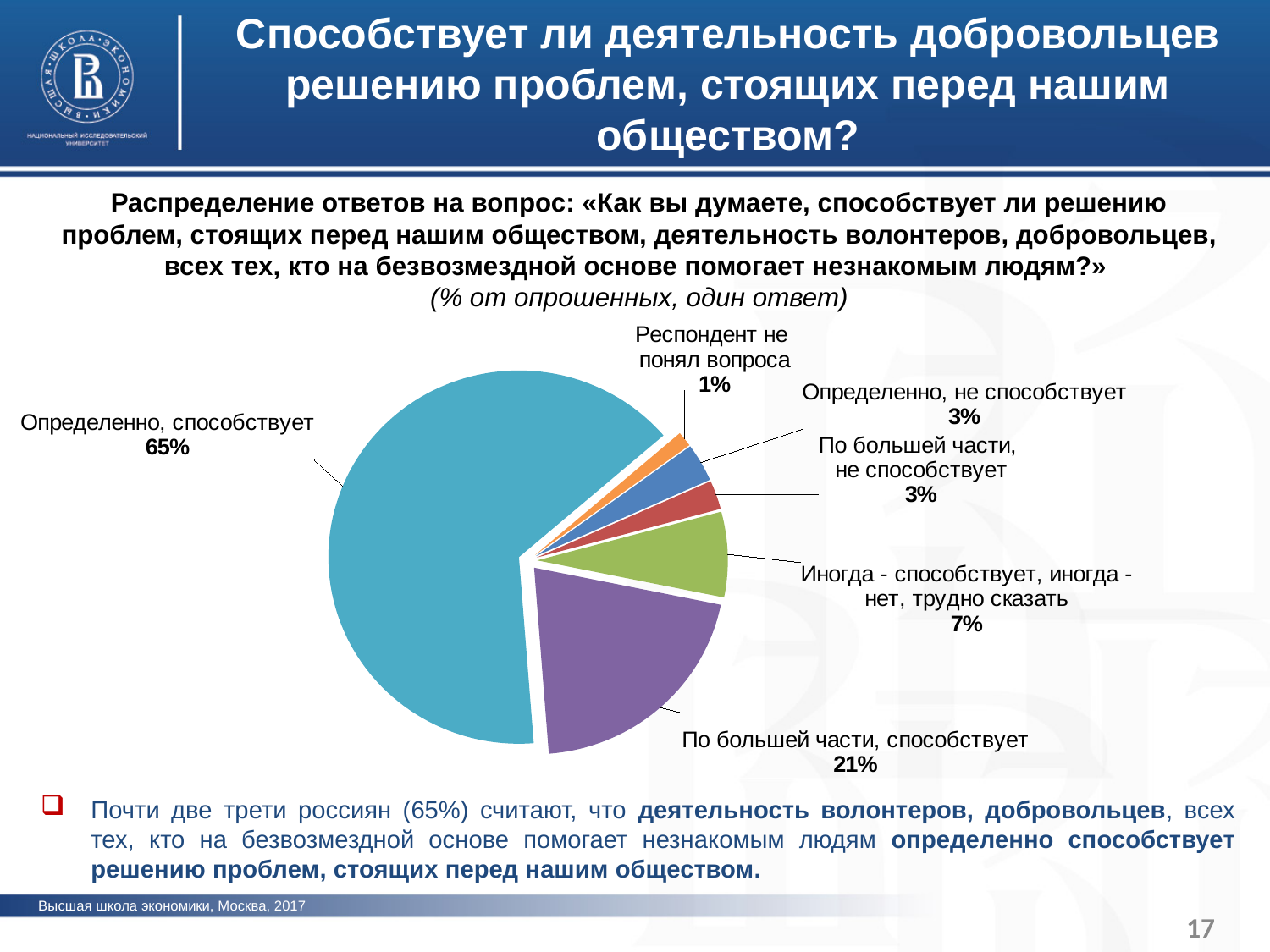
What is the difference in percentage points between «Определенно, способствует» and «По большей части, способствует»? 44 What percentage of respondents did not understand the question («Респондент не понял вопроса»)? 1% What is the combined share of «Определенно, не способствует» and «По большей части, не способствует»? 6% What percentage of respondents answered «Определенно, способствует»? 65% Which is larger: the share for «По большей части, способствует» or for «Иногда - способствует, иногда - нет, трудно сказать»? По большей части, способствует What percentage is shown for «Определенно, не способствует»? 3% What percentage is shown for «Иногда - способствует, иногда - нет, трудно сказать»? 7% Which answer option has the largest share of the pie? Определенно, способствует What type of chart is shown on the slide? Pie chart What share of respondents chose «По большей части, способствует»? 21% Which answer option has the smallest share of the pie? Респондент не понял вопроса How many answer categories are shown in the pie chart? 6